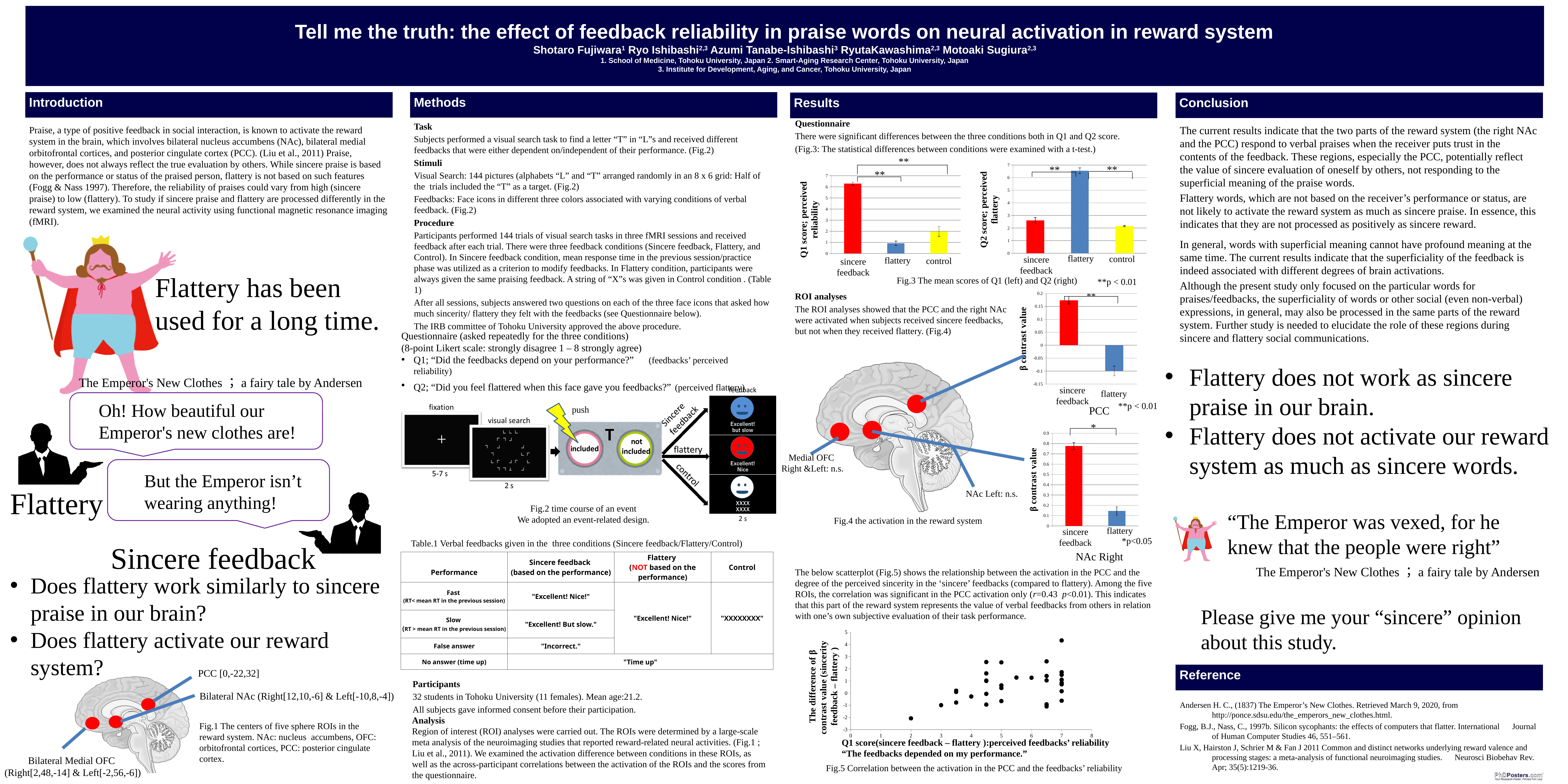
In the Fig.3 left chart (Q1 score; perceived reliability), which condition has the highest score? sincere feedback What kind of chart is the NAc Right β contrast value chart? bar chart How many conditions are shown on the x axis of the Fig.3 left chart (Q1 score; perceived reliability)? 3 In the Fig.3 right chart (Q2 score; perceived flattery), is the value for control greater or less than 3? less In the NAc Right β contrast value chart, is the value for sincere feedback greater or less than 0.5? greater In the PCC β contrast value chart, is the value for flattery greater or less than 0? less In the Fig.3 right chart (Q2 score; perceived flattery), which condition has the highest score? flattery In the Fig.3 right chart (Q2 score; perceived flattery), which is larger, the value for sincere feedback or the value for flattery? flattery In the PCC β contrast value chart, which condition has the higher β contrast value? sincere feedback What kind of chart is Fig.5 (correlation between the activation in the PCC and the feedbacks' reliability)? scatter plot In the Fig.3 left chart (Q1 score; perceived reliability), which condition has the lowest score? flattery